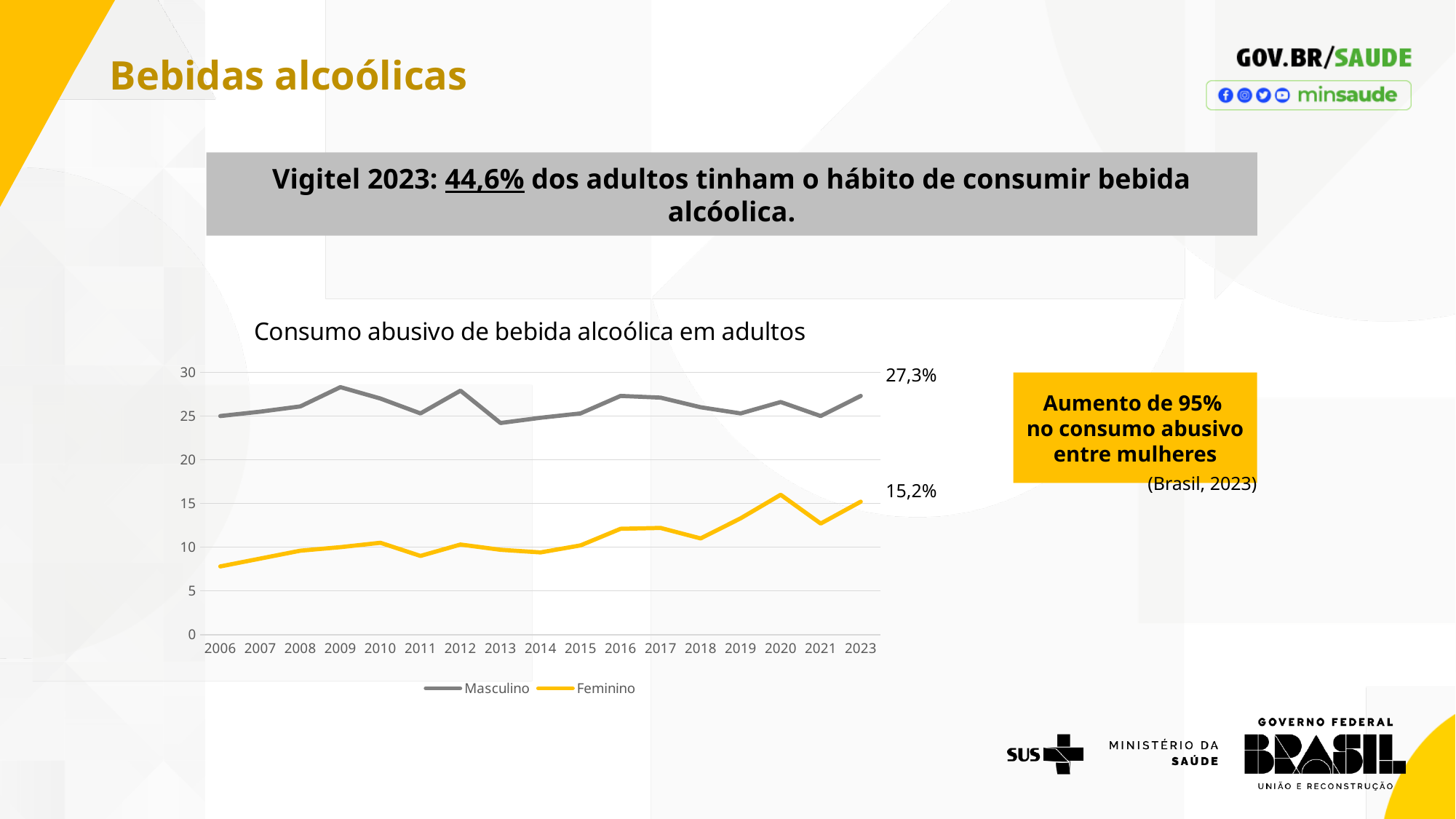
What is the value for Masculino in 2023? 27,3% What is the value for Feminino in 2023? 15,2% How many series does the chart legend list? 2 Is the value for Feminino in 2006 greater or less than 10? less What is the difference between the Masculino and Feminino values in 2023? 12,1 Which series has the higher value in 2023, Masculino or Feminino? Masculino How many years are shown on the x axis of the chart? 17 Is the value for Masculino in 2009 greater or less than 25? greater Is the value for Feminino in 2020 greater or less than 15? greater Does the Feminino line generally rise or fall from 2006 to 2023? rise What is the title of the chart? Consumo abusivo de bebida alcoólica em adultos What kind of chart is shown on the slide? line chart